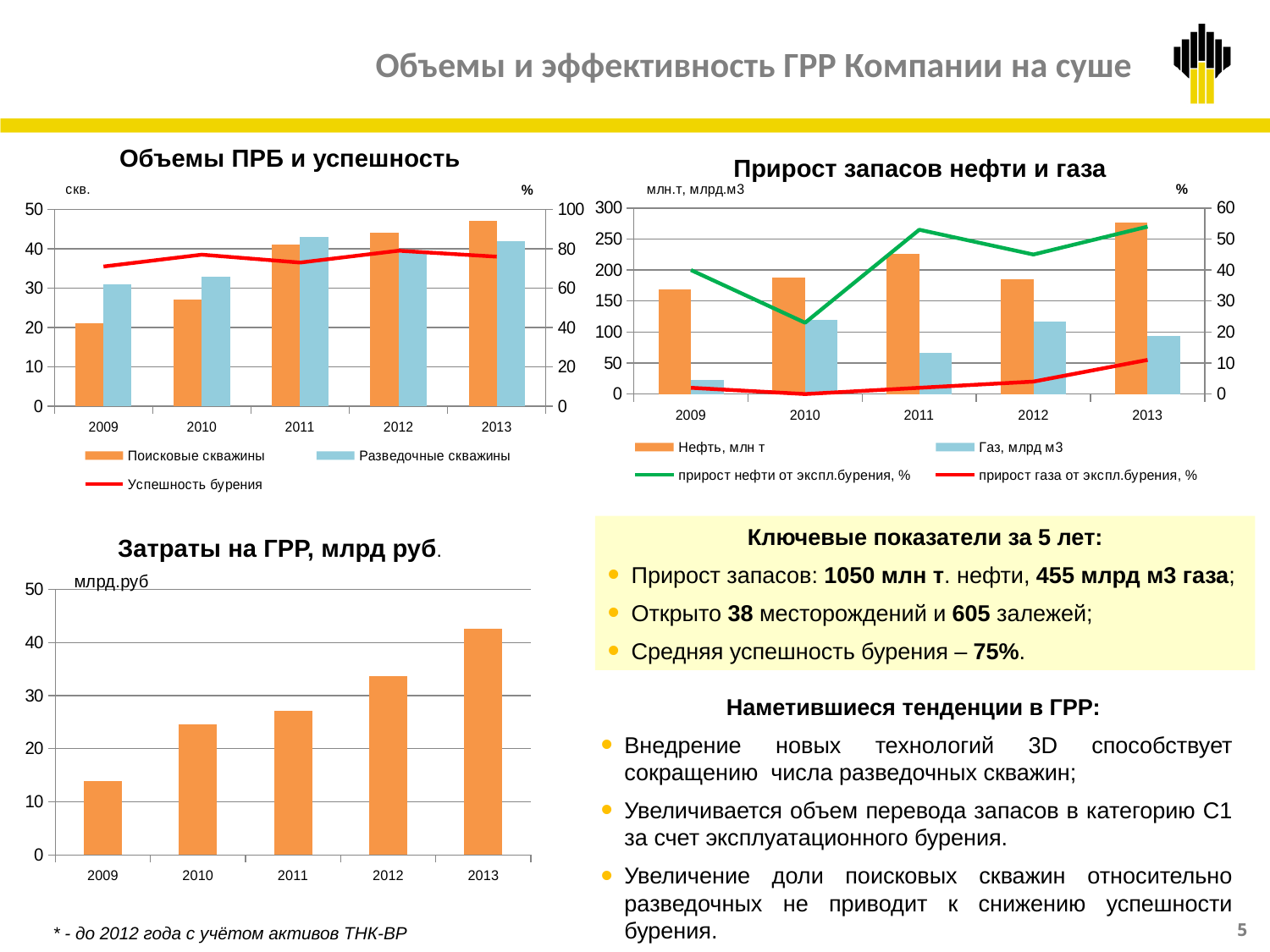
In the 'Объемы ПРБ и успешность' chart, which is larger in 2009: Поисковые скважины or Разведочные скважины? Разведочные скважины In the 'Затраты на ГРР, млрд руб.' chart, which year has the lowest value? 2009 In the 'Затраты на ГРР, млрд руб.' chart, do the values rise or fall from 2009 to 2013? rise In the 'Затраты на ГРР, млрд руб.' chart, is the value for 2013 greater or less than 40? greater How many series does the legend of the 'Прирост запасов нефти и газа' chart list? 4 In the 'Затраты на ГРР, млрд руб.' chart, which year has the highest value? 2013 How many years are shown on the x axis of the 'Затраты на ГРР, млрд руб.' chart? 5 How many series does the legend of the 'Объемы ПРБ и успешность' chart list? 3 In the 'Прирост запасов нефти и газа' chart, which year has the highest value for Нефть, млн т? 2013 What kind of chart is the 'Затраты на ГРР, млрд руб.' chart? bar chart In the 'Объемы ПРБ и успешность' chart, is the value for Поисковые скважины in 2009 greater or less than 30? less In the 'Объемы ПРБ и успешность' chart, which year has the highest value for Поисковые скважины? 2013